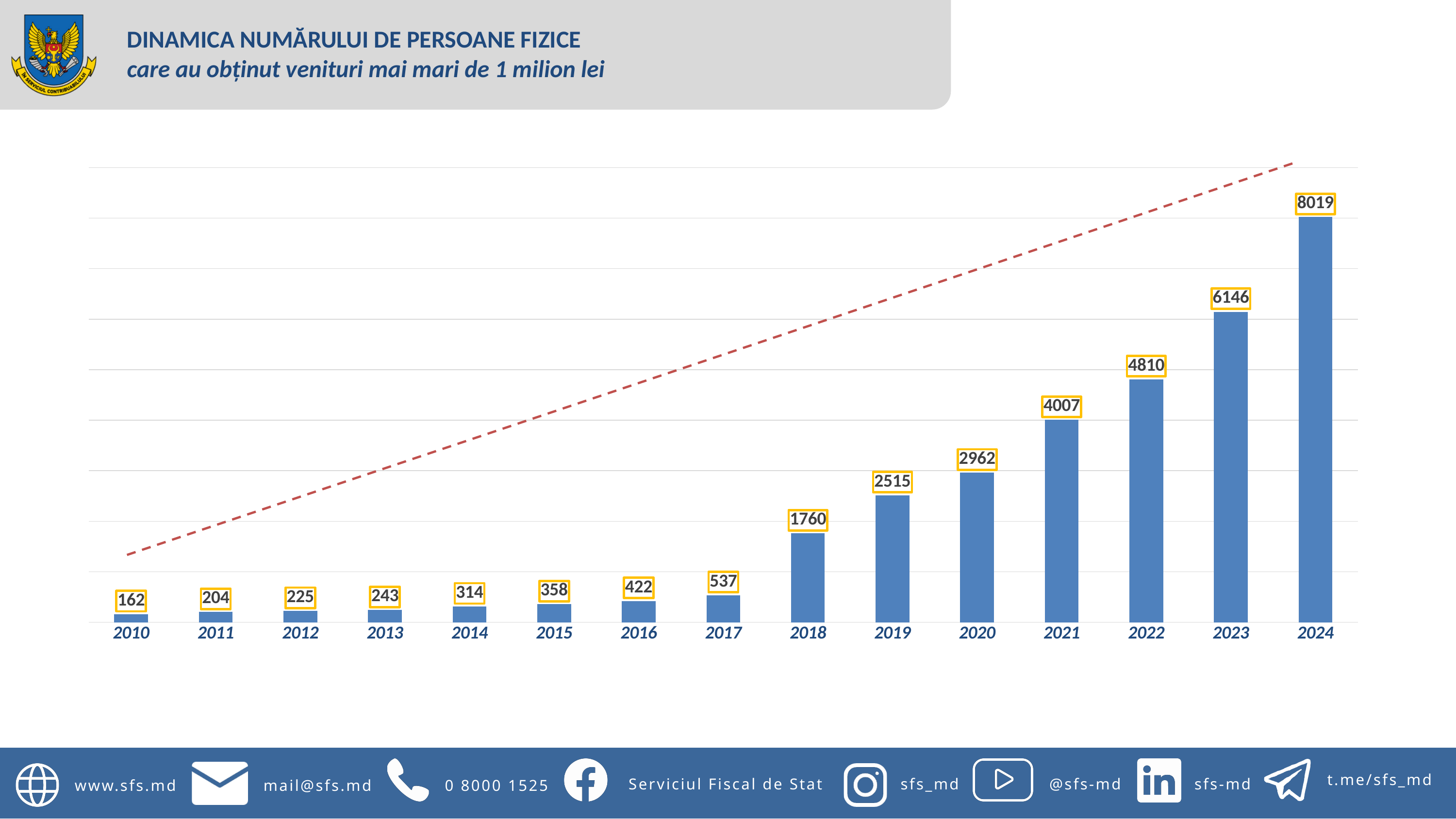
How many years are shown on the x axis? 15 What is the value for 2014? 314 What is the value for 2022? 4810 Which is larger, the value for 2016 or the value for 2017? 2017 Which year has the highest value? 2024 Which year has the lowest value? 2010 What is the value for 2010? 162 What is the difference between the values for 2024 and 2023? 1873 What is the difference between the values for 2019 and 2018? 755 What is the value for 2018? 1760 Do the values rise or fall from 2010 to 2024? rise What kind of chart is this? bar chart